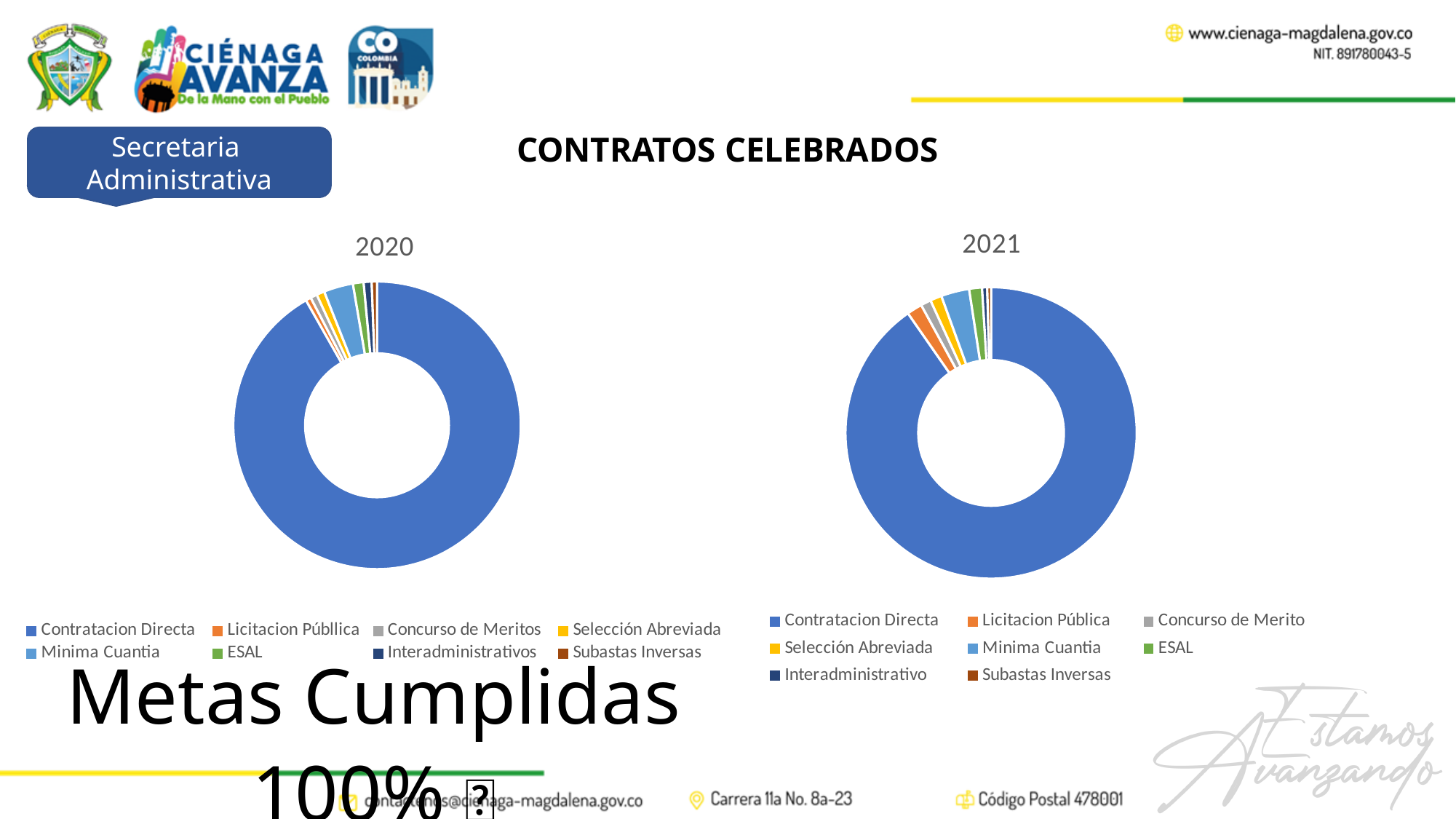
What kind of chart is the 2020 chart? Pie chart (doughnut) What kind of chart is the 2021 chart? Pie chart (doughnut) What is the overall heading above the two charts? CONTRATOS CELEBRADOS In the 2021 chart, which is larger: Contratacion Directa or Licitacion Pública? Contratacion Directa In the 2020 chart, which is larger: Contratacion Directa or Minima Cuantia? Contratacion Directa How many categories does the legend of the 2020 chart list? 8 How many categories does the legend of the 2021 chart list? 8 What is the title of the chart on the left? 2020 In the 2021 chart, which category has the largest slice? Contratacion Directa In the 2020 chart, which category has the largest slice? Contratacion Directa